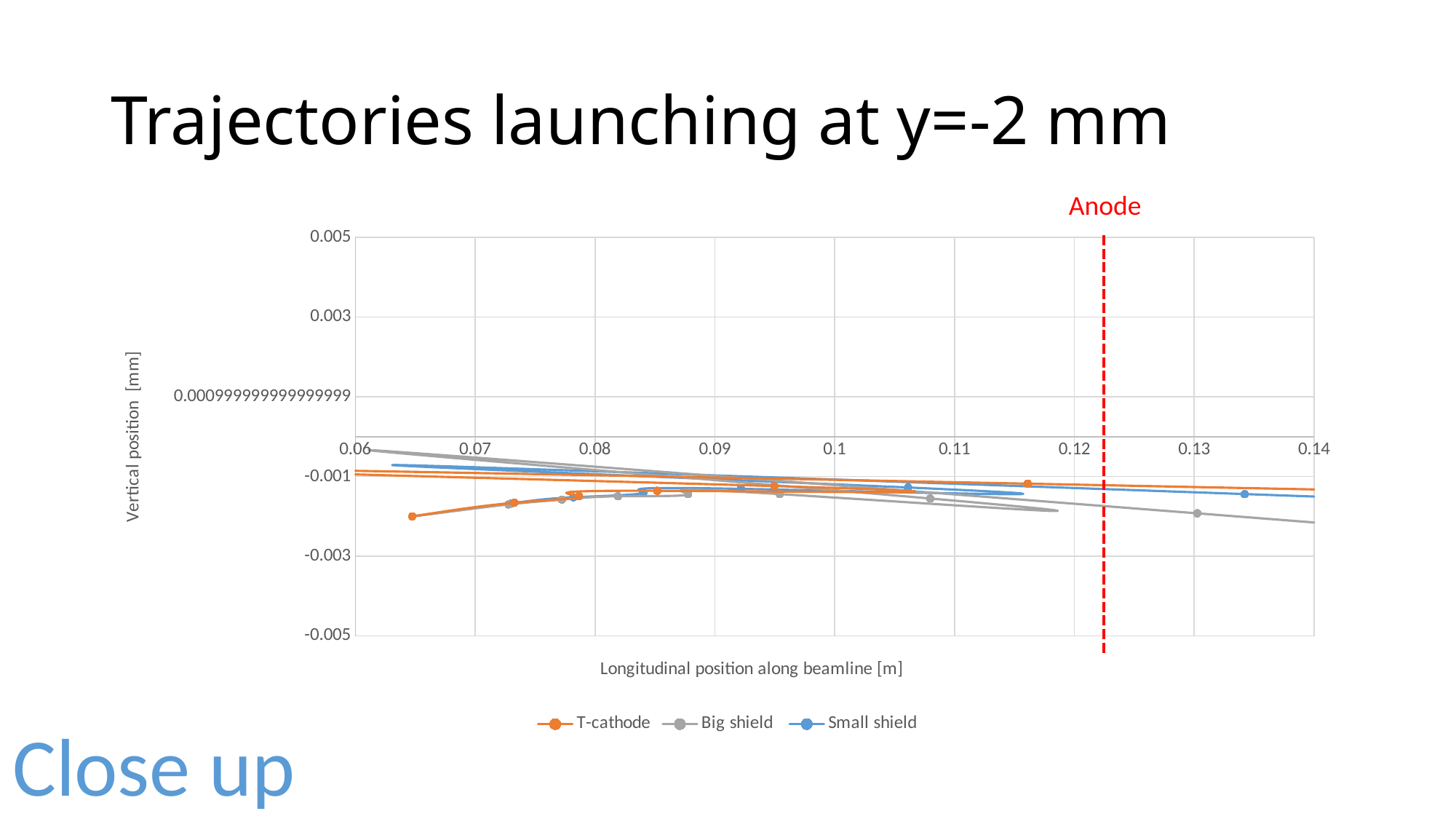
What is the highest value labelled on the vertical axis? 0.005 Is the vertical position of the Small shield series at its rightmost marker (near 0.134) greater or less than -0.003? greater How many series does the legend list? 3 At the right edge of the chart (0.14), which series is higher: Big shield or Small shield? Small shield What is the label of the horizontal axis? Longitudinal position along beamline [m] Is the vertical position of the Big shield series at a longitudinal position of 0.13 greater or less than -0.003? greater What kind of chart is shown on the slide? Line chart Is the vertical position of the T-cathode series at its leftmost marker (near 0.065) greater or less than -0.001? less Which series has the lowest vertical position at the right edge of the chart (0.14)? Big shield What does the red dashed vertical line on the chart mark? Anode What is the lowest value labelled on the horizontal axis? 0.06